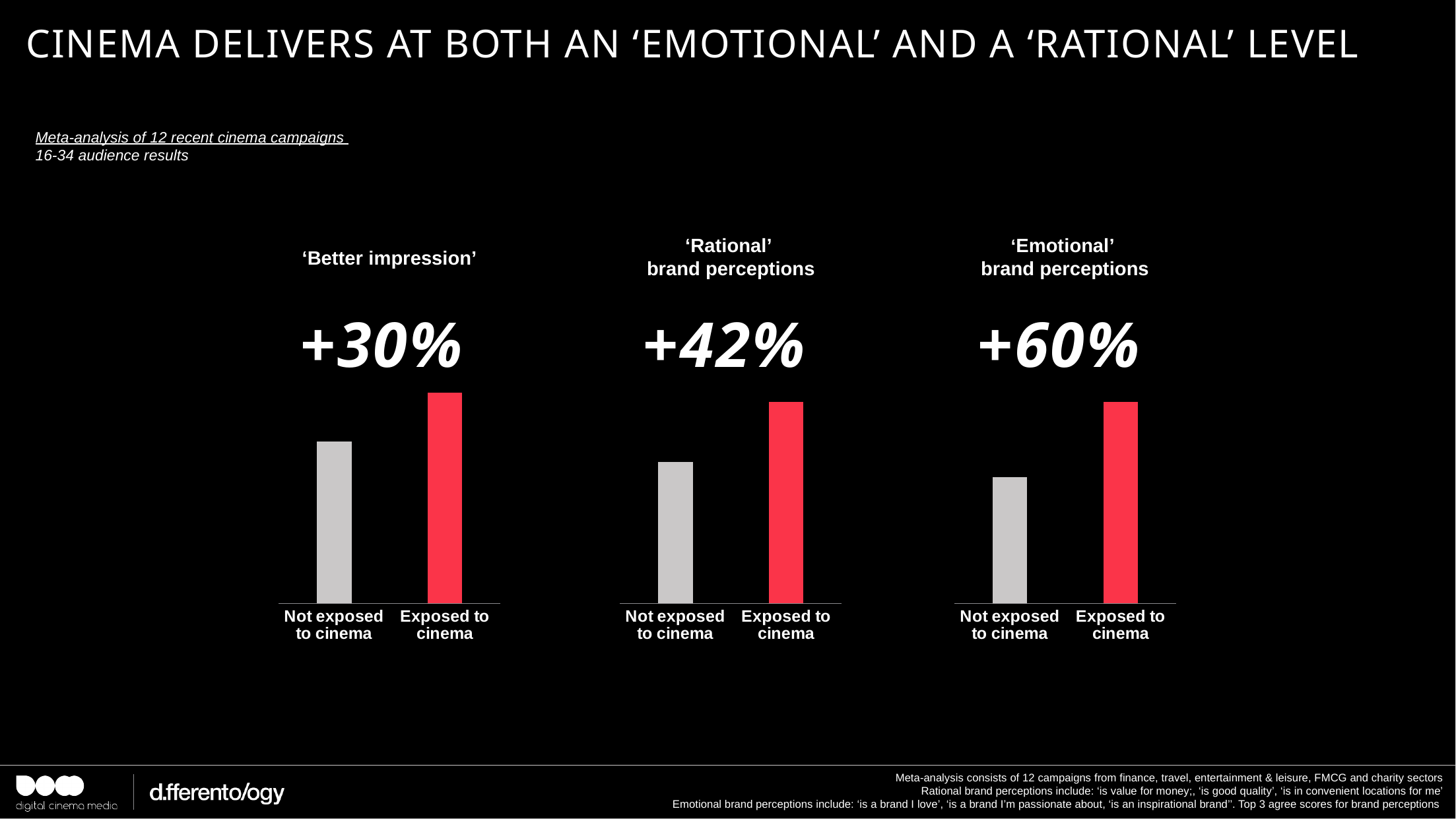
In the 'Better impression' chart, how many bars are plotted? 2 In the 'Better impression' chart, which bar is taller: 'Not exposed to cinema' or 'Exposed to cinema'? Exposed to cinema What uplift percentage is printed above the 'Emotional' brand perceptions chart? +60% How many separate bar charts are shown on the slide? 3 In the 'Rational' brand perceptions chart, what colour is the 'Exposed to cinema' bar? red What uplift percentage is printed above the 'Rational' brand perceptions chart? +42% In the 'Emotional' brand perceptions chart, which category has the highest bar? Exposed to cinema Which of the three charts shows the largest printed uplift? 'Emotional' brand perceptions What kind of chart is used under the 'Better impression' heading? bar chart What uplift percentage is printed above the 'Better impression' chart? +30% Which of the three charts shows the smallest printed uplift? 'Better impression' In the 'Rational' brand perceptions chart, which category has the lowest bar? Not exposed to cinema